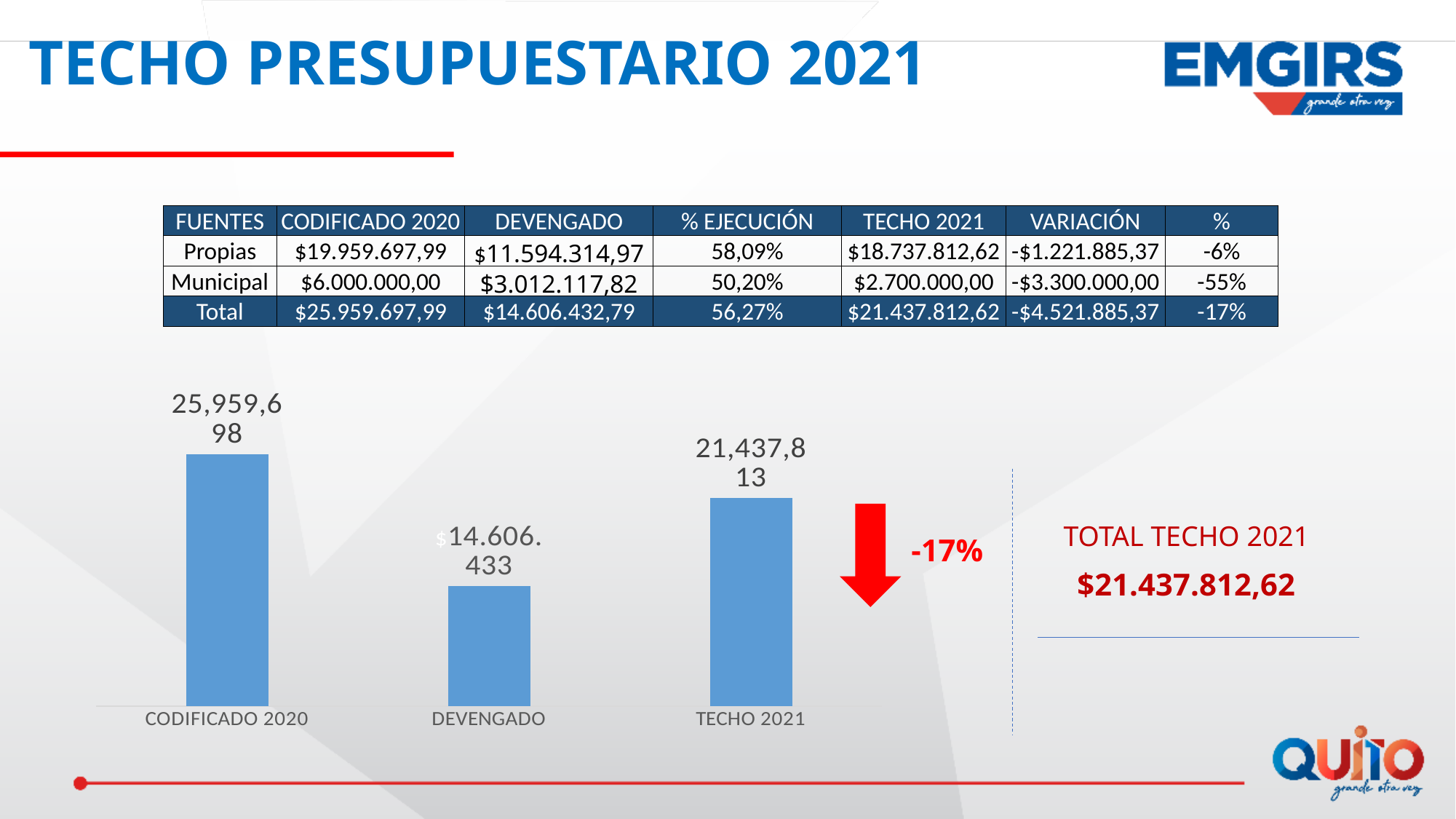
Which category has the highest bar in the chart? CODIFICADO 2020 What is the difference between the CODIFICADO 2020 value and the TECHO 2021 value in the bar chart? 4,521,885 How many bars are plotted in the chart? 3 What kind of chart is shown on the slide? Bar chart Which category has the lowest bar in the chart? DEVENGADO What percentage is printed next to the red arrow beside the bar chart? -17% Does the value fall or rise from CODIFICADO 2020 to DEVENGADO in the bar chart? Fall What value is shown for TECHO 2021 in the bar chart? 21,437,813 What colour are the bars in the chart? Blue Which is larger in the bar chart, TECHO 2021 or DEVENGADO? TECHO 2021 What value is shown for CODIFICADO 2020 in the bar chart? 25,959,698 What value is shown for DEVENGADO in the bar chart? $14.606.433